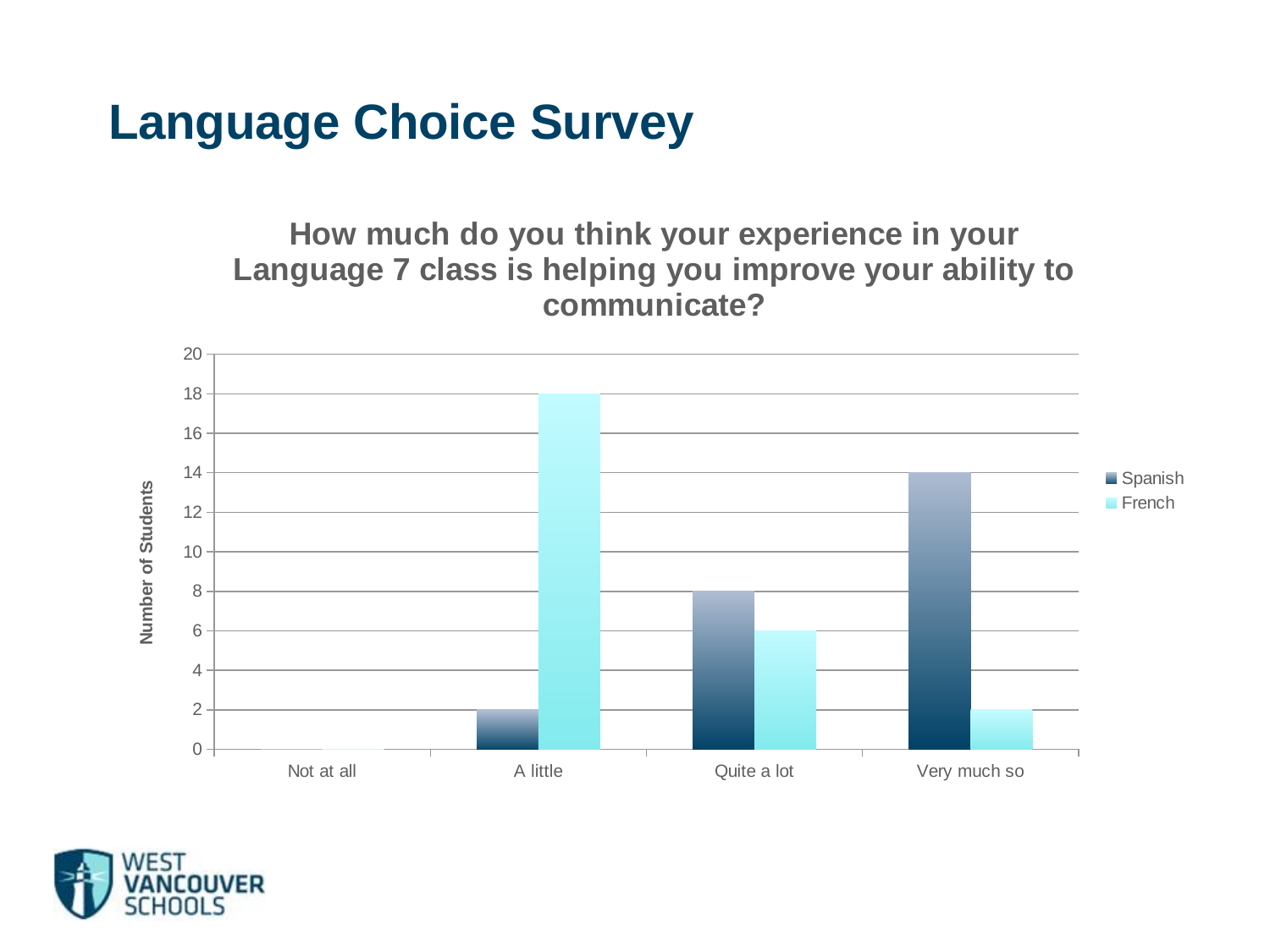
How many series does the legend list? 2 What is the value for Spanish in the 'Very much so' category? 14 What is the value for French in the 'A little' category? 18 Which category has the highest value for Spanish? Very much so What is the value for French in the 'Very much so' category? 2 Which is larger in the 'Quite a lot' category, Spanish or French? Spanish How many categories are shown on the x axis? 4 What is the value for Spanish in the 'Quite a lot' category? 8 What kind of chart is shown on the slide? bar chart What is the difference between the French and Spanish values in the 'A little' category? 16 What is the label of the y axis? Number of Students Which category has the highest value for French? A little